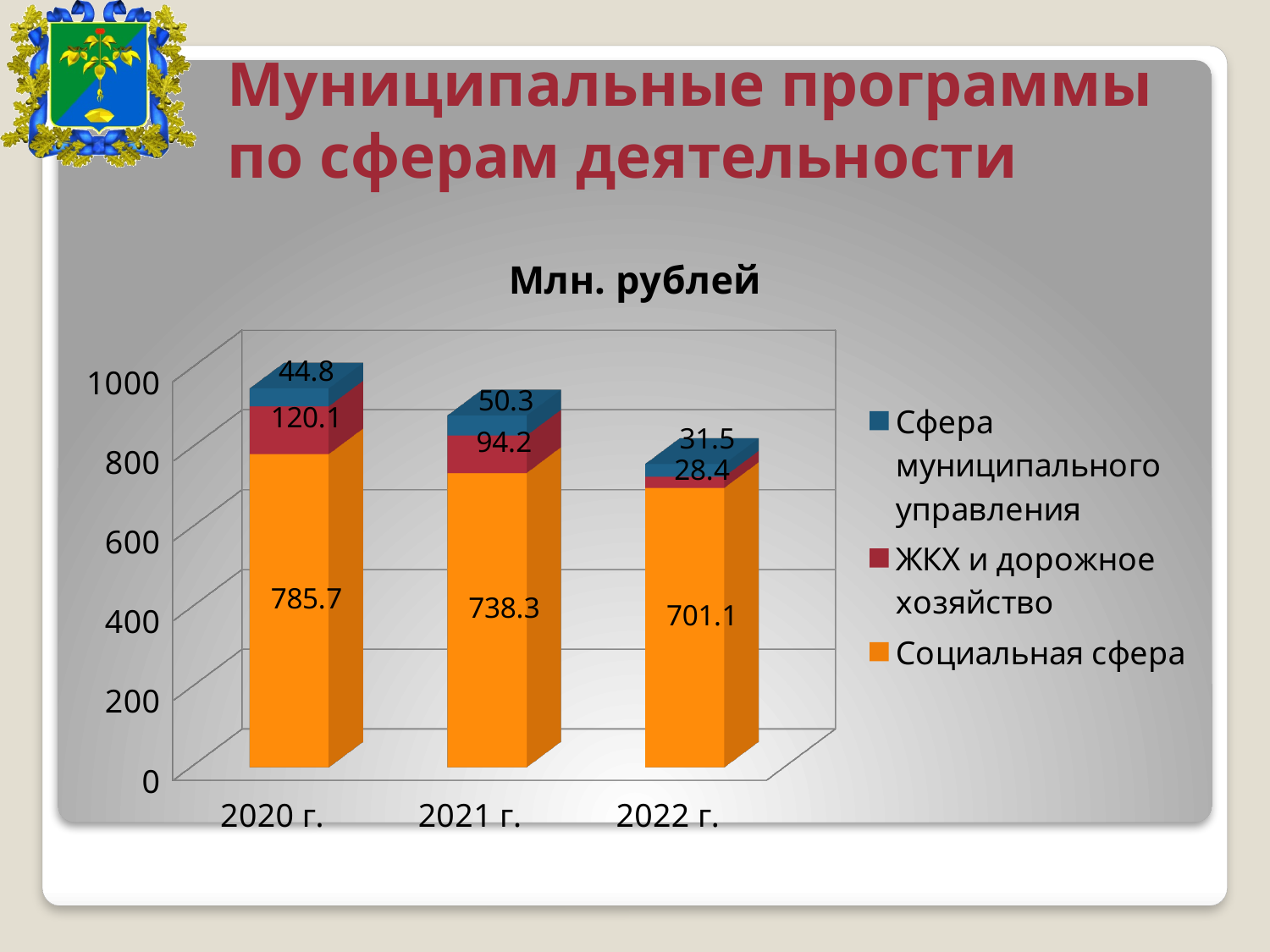
In which year is the value for ЖКХ и дорожное хозяйство the lowest? 2022 г. What is the value for Сфера муниципального управления in 2022 г.? 31.5 What is the value for Социальная сфера in 2020 г.? 785.7 How many years are shown on the x axis? 3 In which year is the value for Социальная сфера the highest? 2020 г. Does the value for Социальная сфера rise or fall from 2020 г. to 2022 г.? Fall How many series does the legend list? 3 What is the total of the stacked bar for 2021 г.? 882.8 What is the value for ЖКХ и дорожное хозяйство in 2021 г.? 94.2 Which is larger: Сфера муниципального управления in 2020 г. or in 2021 г.? 2021 г. What kind of chart is shown on the slide? Stacked bar chart What is the difference between the Социальная сфера values for 2020 г. and 2022 г.? 84.6